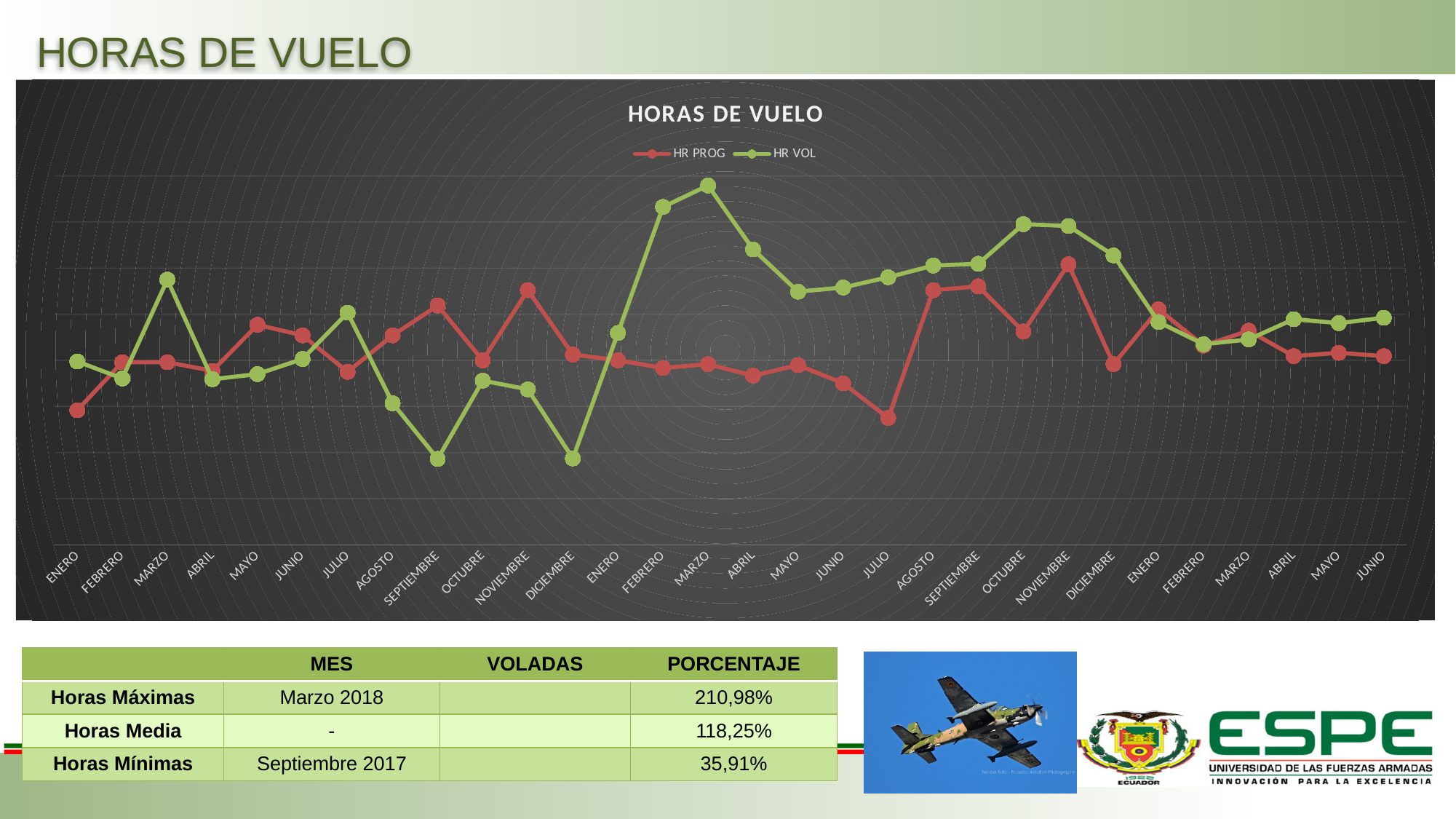
Does the HR VOL series rise or fall between the second MARZO and the second MAYO on the x axis? fall What is the title of the chart? HORAS DE VUELO At which month on the x axis does the HR PROG series reach its highest value? the second NOVIEMBRE At the second JULIO on the x axis, which series has the larger value, HR PROG or HR VOL? HR VOL What are the two series named in the chart legend? HR PROG and HR VOL At the second MARZO on the x axis, which series has the larger value, HR PROG or HR VOL? HR VOL How many data points (months) are plotted along the x axis of the chart? 30 At the first SEPTIEMBRE on the x axis, which series has the larger value, HR PROG or HR VOL? HR PROG How many series does the chart legend list? 2 At which month on the x axis does the HR VOL series reach its highest value? the second MARZO What kind of chart is shown on the slide? line chart Does the HR VOL series rise or fall between the second FEBRERO and the second MARZO on the x axis? rise